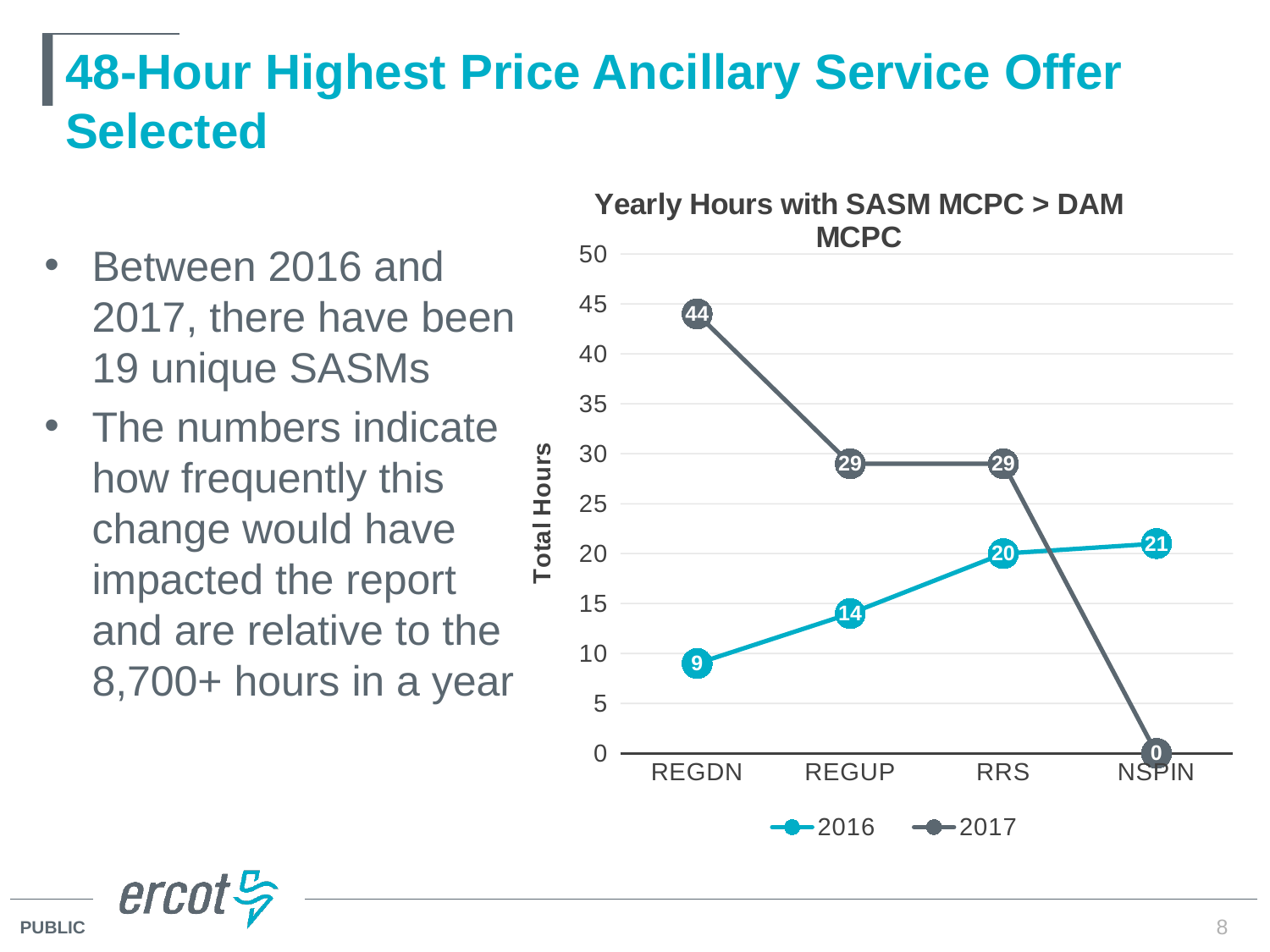
How many series does the legend list? 2 What kind of chart is shown on the slide? line chart What is the title of the chart? Yearly Hours with SASM MCPC > DAM MCPC What is the difference between the 2017 and 2016 values for REGDN? 35 What is the value for REGUP in the 2016 series? 14 Which category has the lowest value in the 2016 series? REGDN Is the value for RRS in the 2017 series greater or less than 25? greater Which series has the larger value for NSPIN, 2016 or 2017? 2016 What is the value for REGDN in the 2017 series? 44 How many categories are shown on the x axis? 4 What is the value for NSPIN in the 2017 series? 0 Which category has the highest value in the 2017 series? REGDN